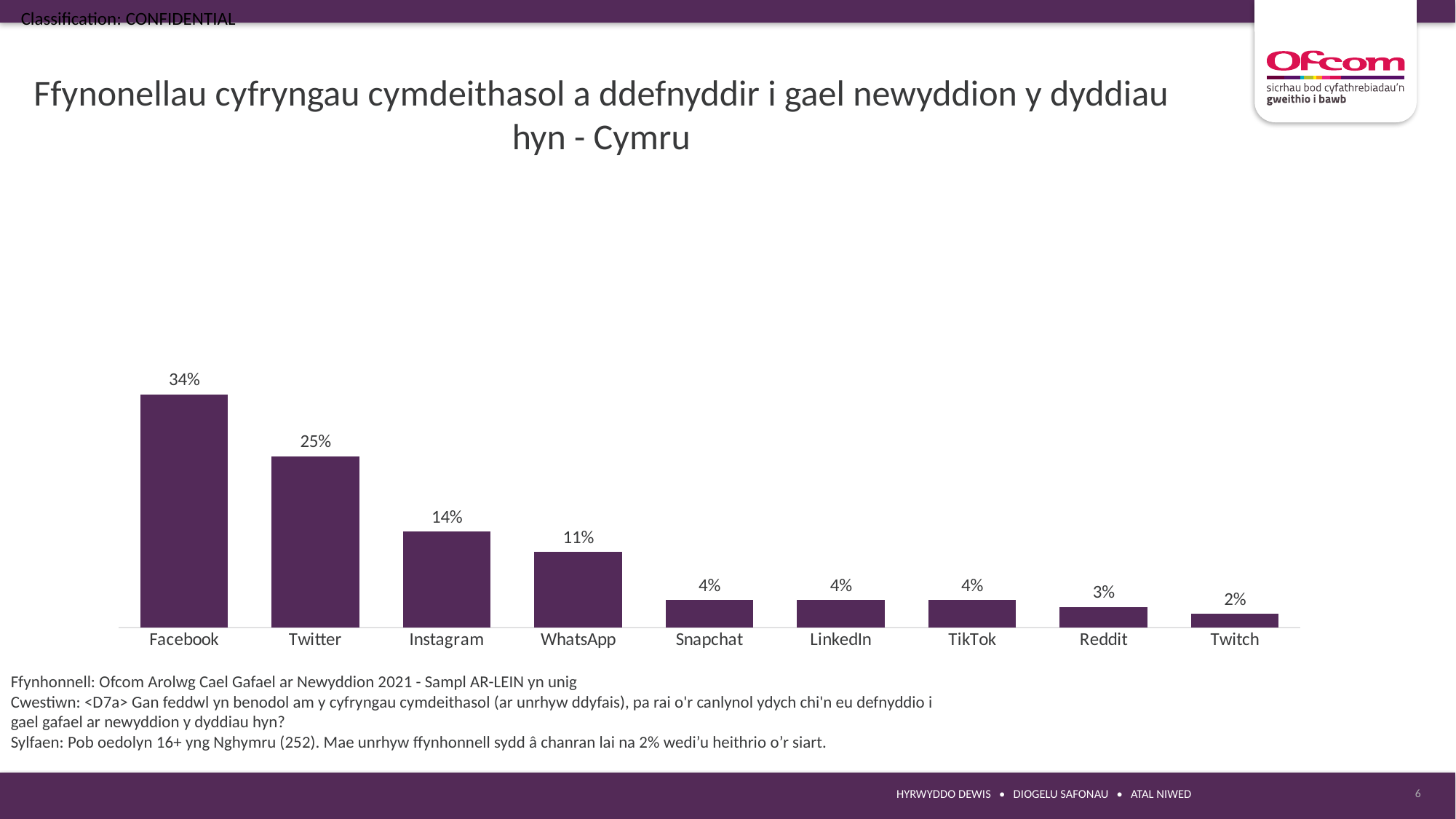
What is the value for Reddit? 3% What is the value for Facebook? 34% Which category has the highest value? Facebook Which is larger, the value for Twitter or the value for Instagram? Twitter Which category has the lowest value? Twitch Do the values rise or fall from left to right along the x axis? Fall What kind of chart is shown on the slide? Bar chart What is the difference between the values for Instagram and WhatsApp? 3% What is the value for WhatsApp? 11% How many categories are shown on the chart? 9 What is the difference between the values for Facebook and Twitter? 9% What is the title of the chart? Ffynonellau cyfryngau cymdeithasol a ddefnyddir i gael newyddion y dyddiau hyn - Cymru